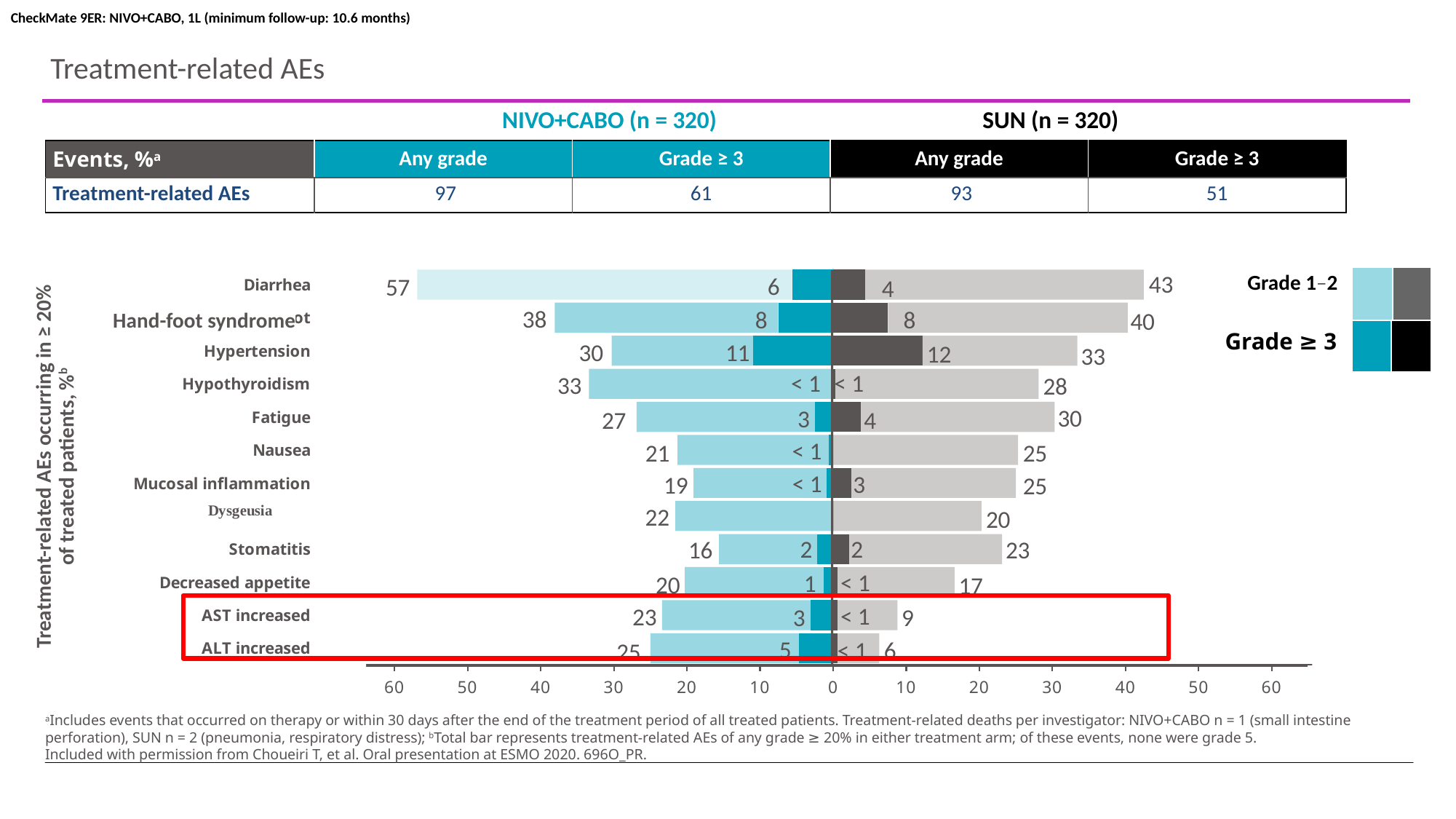
What type of chart is shown on the slide? bar chart Which AE has the lowest any-grade percentage in the SUN arm? ALT increased For hand-foot syndrome, which arm has the higher any-grade percentage, NIVO+CABO or SUN? SUN Which AE has the highest any-grade percentage in the NIVO+CABO arm? Diarrhea What is the difference between the any-grade percentage of diarrhea in the NIVO+CABO arm and in the SUN arm? 14 How many treatment-related AEs are listed as categories in the chart? 12 What is the any-grade percentage of diarrhea in the NIVO+CABO arm? 57 What is the grade ≥ 3 percentage of hypertension in the SUN arm? 12 Which AE has the highest grade ≥ 3 percentage in the NIVO+CABO arm? Hypertension What is the any-grade percentage of ALT increased in the SUN arm? 6 Which two AEs are highlighted by the red box on the chart? AST increased and ALT increased How many grade categories does the chart legend list? 2